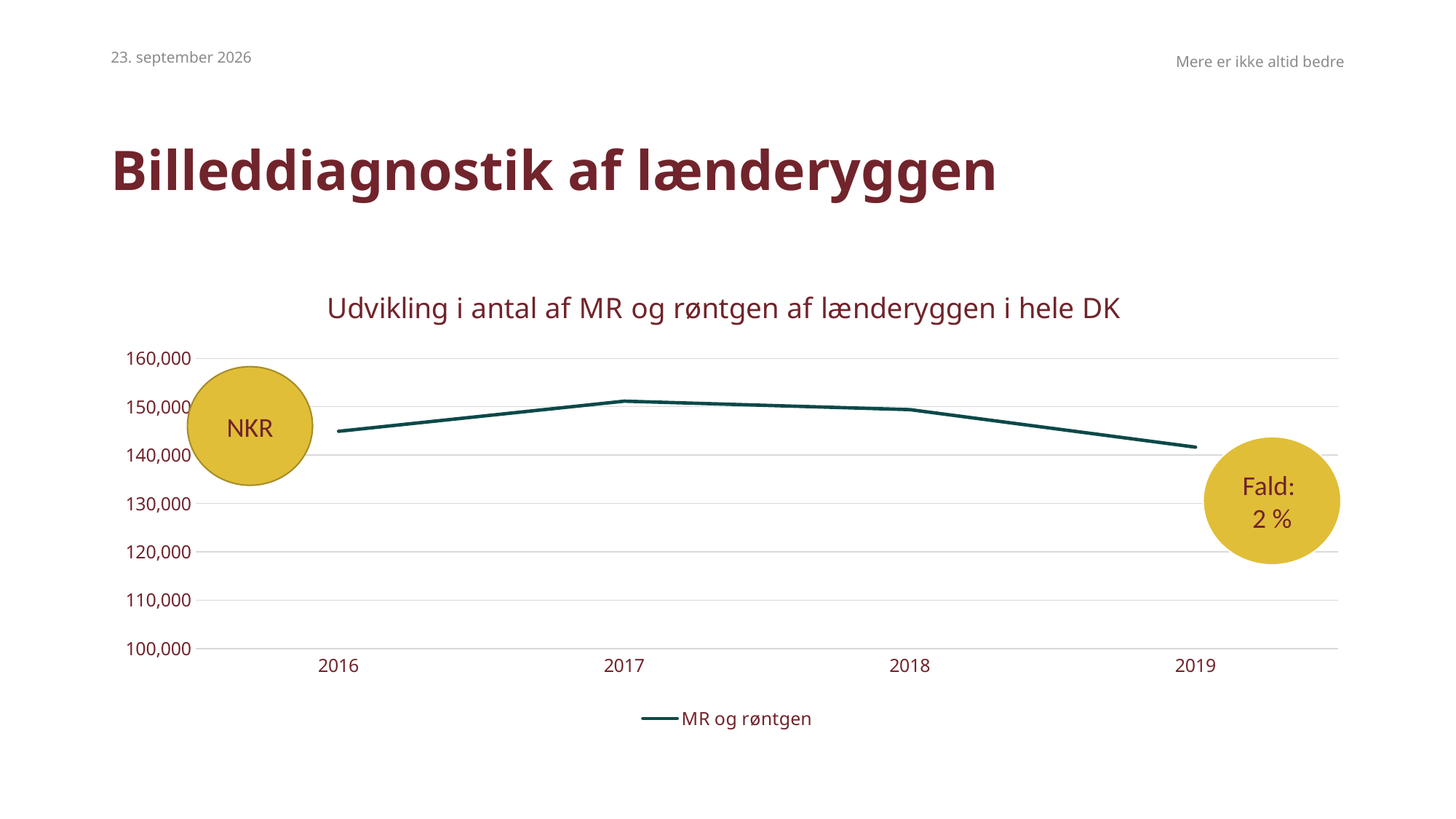
In which year is the value for MR og røntgen lowest? 2019 Which year has the larger value, 2016 or 2019? 2016 Is the value for 2016 greater or less than 140,000? greater What is the name of the series shown in the legend? MR og røntgen Does the value for MR og røntgen rise or fall from 2017 to 2019? fall Which year has the larger value, 2017 or 2019? 2017 Is the value for 2019 greater or less than 150,000? less In which year is the value for MR og røntgen highest? 2017 How many years are plotted on the x axis? 4 What is the title of the chart? Udvikling i antal af MR og røntgen af lænderyggen i hele DK How many series does the legend list? 1 What kind of chart is shown on the slide? line chart